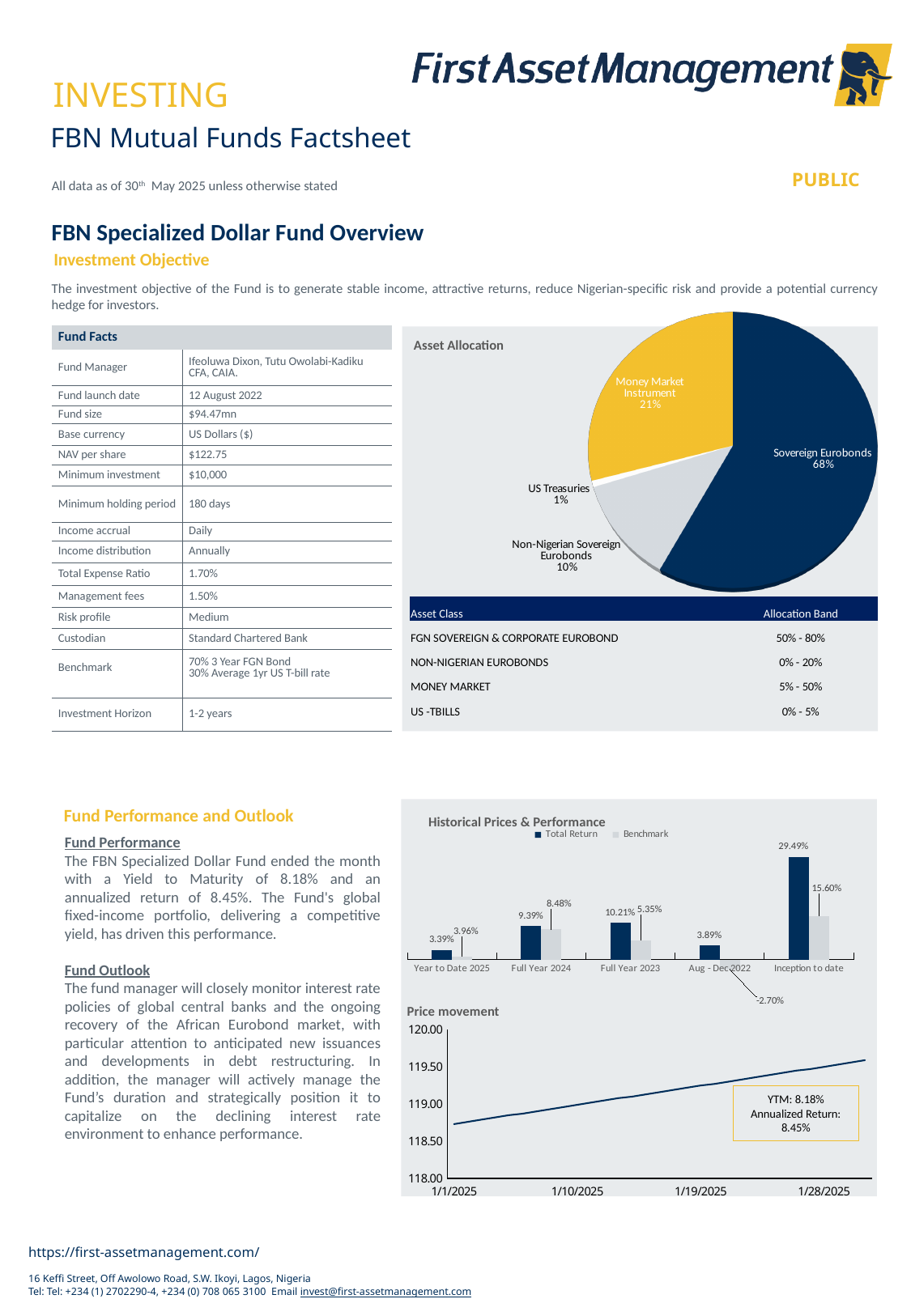
In the Historical Prices & Performance chart, which is larger for Year to Date 2025, Total Return or Benchmark? Benchmark In the Asset Allocation pie chart, which asset class has the smallest slice? US Treasuries In the Asset Allocation pie chart, what share of the fund is allocated to Sovereign Eurobonds? 68% In the Historical Prices & Performance chart, what is the Total Return for Full Year 2023? 10.21% How many series does the legend of the Historical Prices & Performance chart list? 2 In the Historical Prices & Performance chart, which period has the highest Total Return? Inception to date What type of chart is the Asset Allocation chart? Pie chart In the Price movement chart, does the price rise or fall from 1/1/2025 to 1/28/2025? Rise How many slices does the Asset Allocation pie chart have? 4 In the Historical Prices & Performance chart, what is the Benchmark value for Aug - Dec 2022? -2.70% In the Historical Prices & Performance chart, what is the difference between Total Return and Benchmark for Inception to date? 13.89% In the Asset Allocation pie chart, what percentage is allocated to Money Market Instrument? 21%